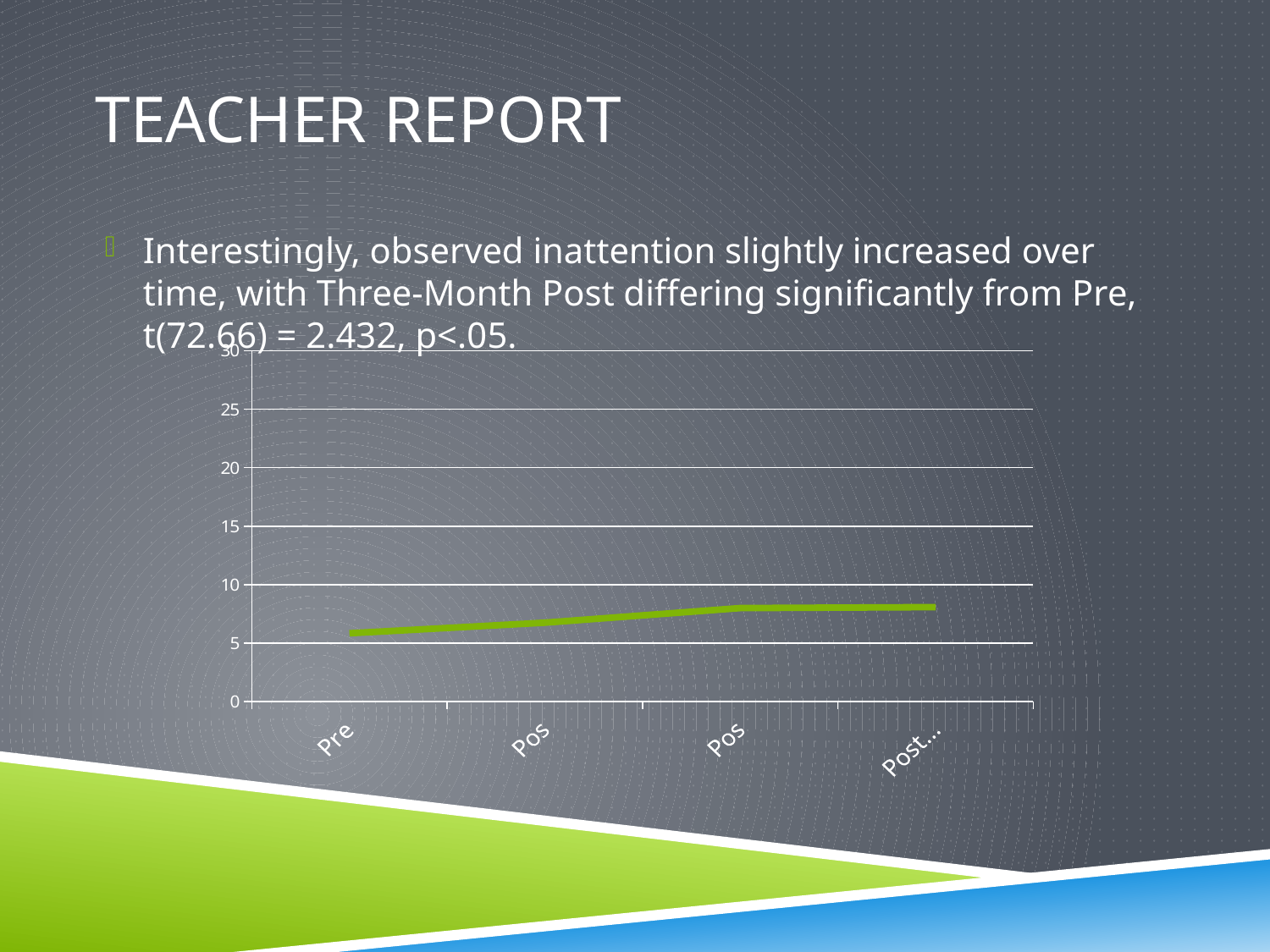
Is the value for Pre greater or less than 5? greater Is the value at the last (rightmost) point greater or less than 10? less Is the value at the last (rightmost) point greater or less than 5? greater What kind of chart is shown on the slide? line chart How many data points are plotted on the line? 4 Which is larger, the value at Pre or the value at the last (rightmost) point? the last (rightmost) point Do the values rise or fall from Pre to the final Post point along the x axis? rise What is the highest value shown on the y axis? 30 What is the label of the first category on the x axis? Pre Which point on the line has the lowest value? Pre